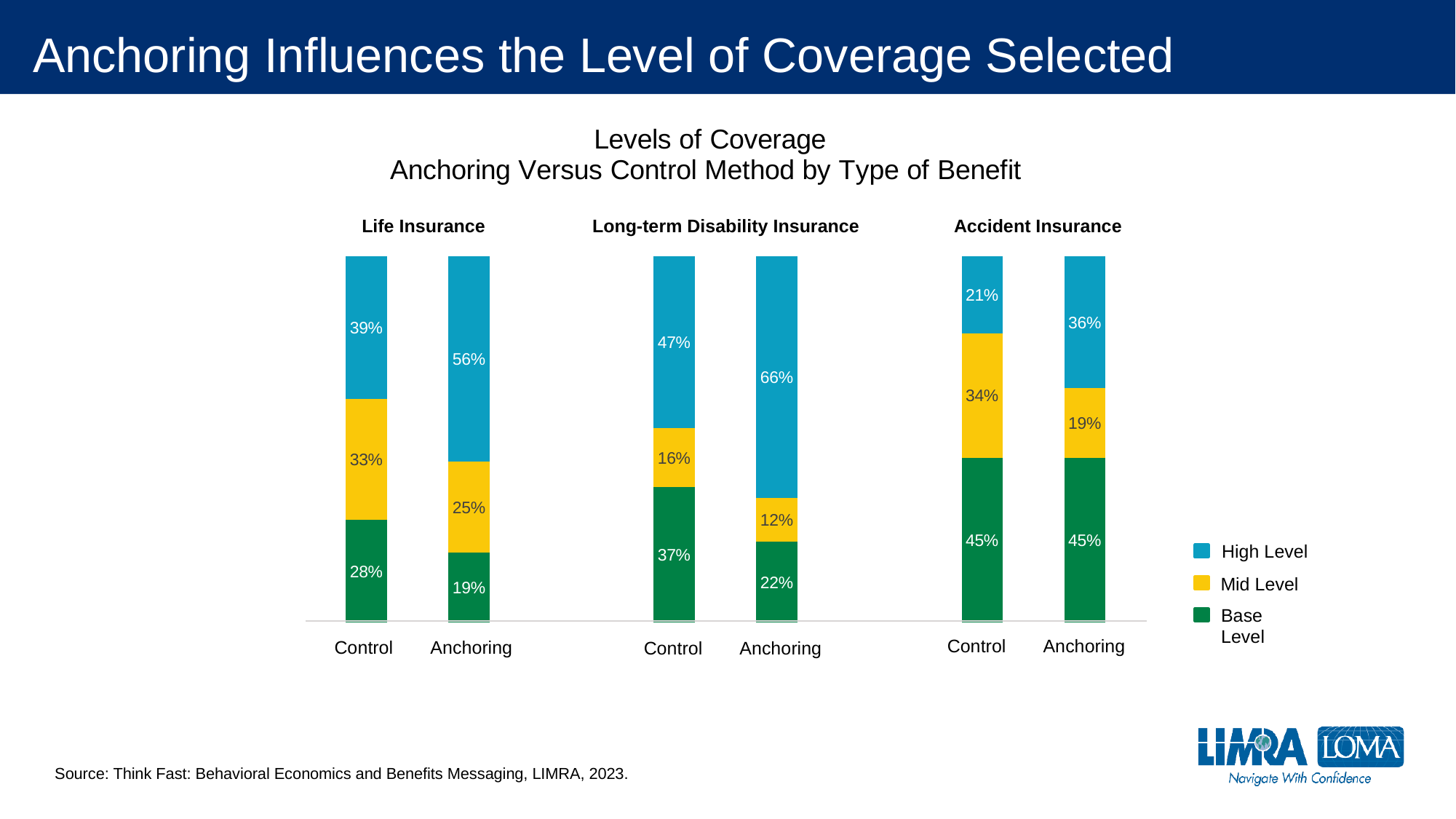
What is the Mid Level share for the Accident Insurance Anchoring bar? 19% What is the High Level share for the Life Insurance Anchoring bar? 56% Which bar has the highest High Level share across all three benefit types? Long-term Disability Insurance Anchoring What kind of chart is shown on the slide? Stacked bar chart For Long-term Disability Insurance, which has the larger Base Level share, Control or Anchoring? Control Which bar has the lowest Mid Level share across all three benefit types? Long-term Disability Insurance Anchoring What is the difference between the Mid Level shares of the Control and Anchoring bars for Accident Insurance? 15% What is the difference between the High Level shares of the Anchoring and Control bars for Life Insurance? 17% How many series does the legend list? 3 What is the High Level share for the Accident Insurance Control bar? 21% What is the Base Level share for the Long-term Disability Insurance Control bar? 37% Which colour represents the Mid Level series in the chart? Yellow